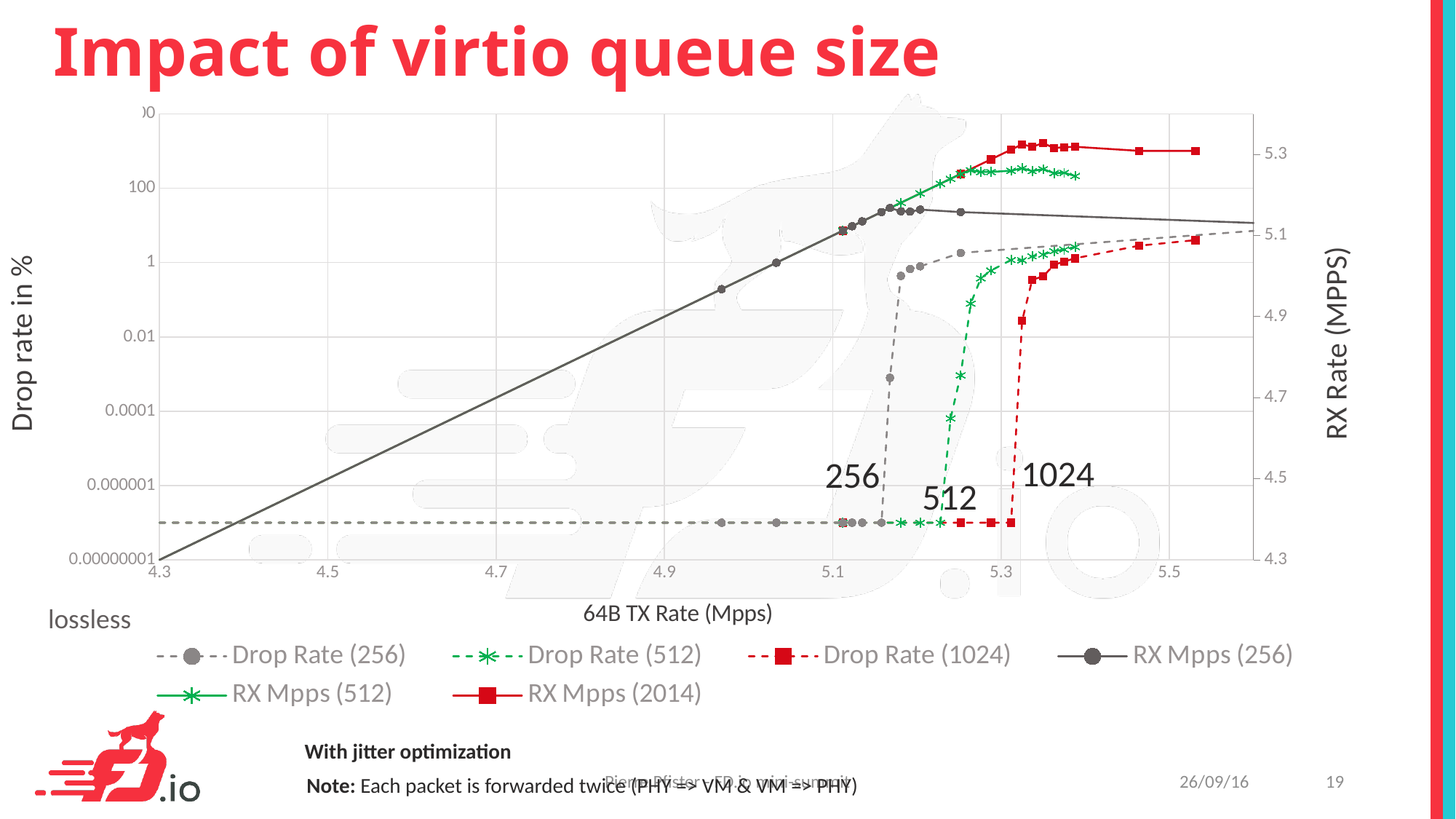
Does the RX Mpps (256) series rise or fall as the TX rate increases from 4.3 to 5.1? rise Which drop-rate series starts rising at the lowest TX rate? Drop Rate (256) Which drop-rate series starts rising at the highest TX rate? Drop Rate (1024) Is the value of RX Mpps (256) at a TX rate of 4.9 greater or less than 5.1? less What is the title of the left y axis? Drop rate in % How many series does the legend list? 6 What is the title of the chart's x axis? 64B TX Rate (Mpps) What kind of chart is shown on the slide? line chart Does the Drop Rate (512) series rise or fall as the TX rate increases beyond 5.2? rise Is the peak value of RX Mpps (512) greater or less than 5.3 on the right axis? less Is the value of Drop Rate (1024) at a TX rate of 5.1 greater or less than 0.000001? less Which series reaches a higher RX rate, RX Mpps (2014) or RX Mpps (256)? RX Mpps (2014)